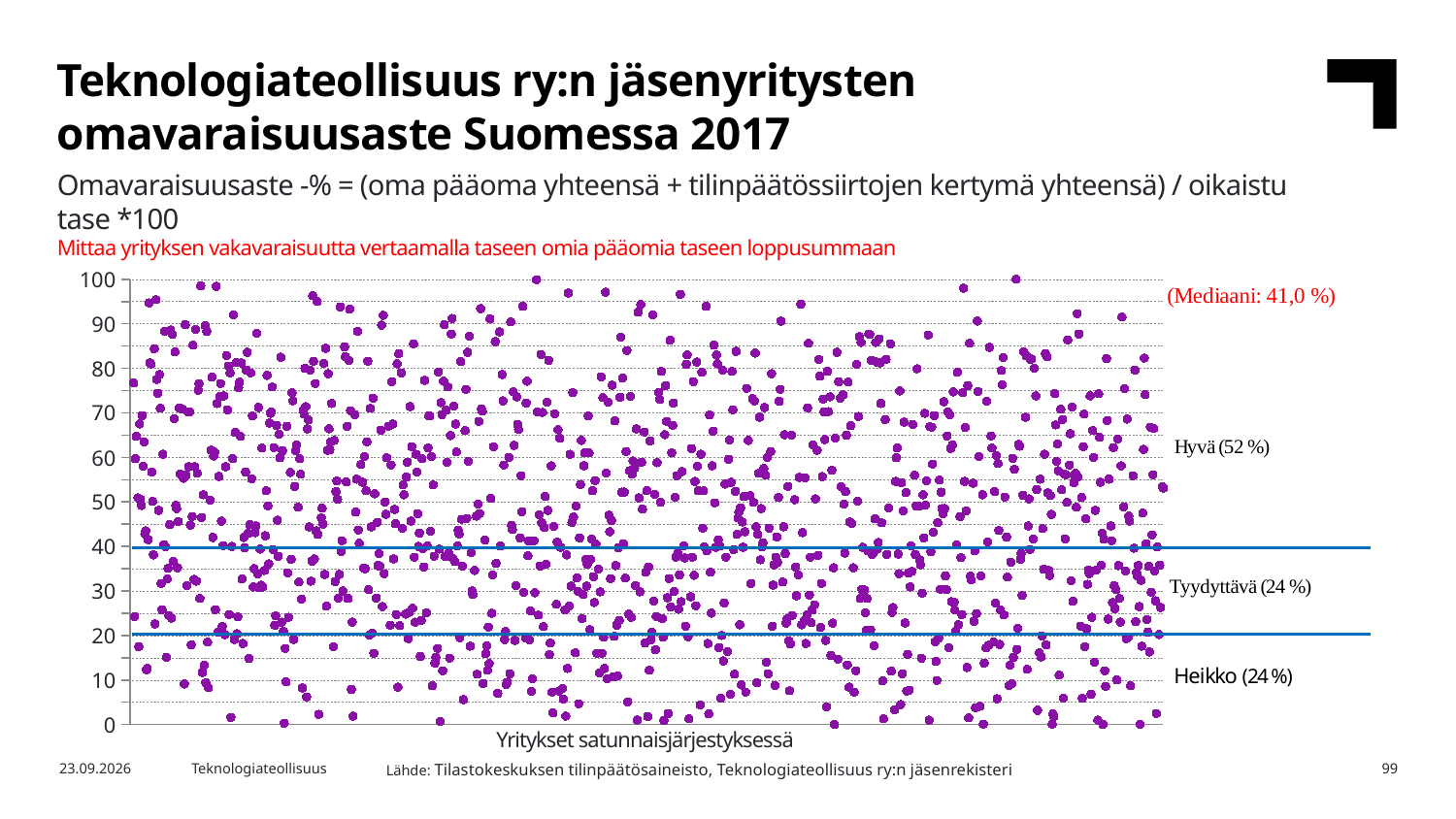
What share of companies falls into the 'Tyydyttävä' category according to the chart label? 24 % What share of companies falls into the 'Hyvä' category according to the chart label? 52 % What is the highest value shown on the vertical axis? 100 Is the share of 'Hyvä' larger or smaller than the share of 'Heikko'? larger What share of companies falls into the 'Heikko' category according to the chart label? 24 % What median value is printed on the chart? 41,0 % What kind of chart is shown on the slide? scatter chart Is the median value (41,0 %) greater or less than 40? greater Which of the three categories (Hyvä, Tyydyttävä, Heikko) has the largest share of companies? Hyvä At which two vertical-axis values are the horizontal blue threshold lines drawn? 40 and 20 What is the label of the horizontal axis? Yritykset satunnaisjärjestyksessä By how many percentage points does the share of 'Hyvä' exceed the share of 'Tyydyttävä'? 28